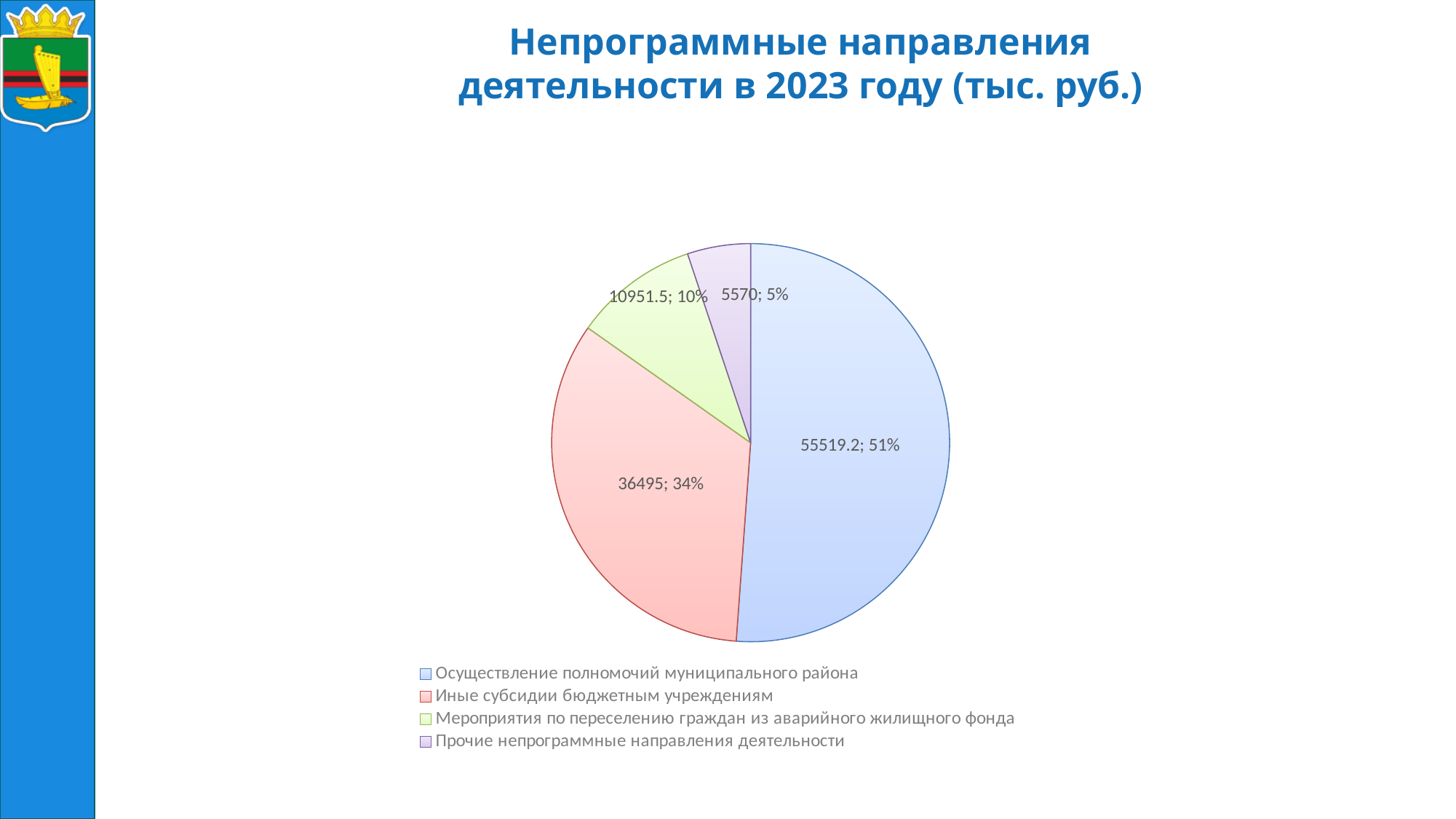
Which category has the smallest slice of the pie? Прочие непрограммные направления деятельности Which category has the largest slice of the pie? Осуществление полномочий муниципального района Which is larger: the value for "Мероприятия по переселению граждан из аварийного жилищного фонда" or the value for "Прочие непрограммные направления деятельности"? Мероприятия по переселению граждан из аварийного жилищного фонда What share of the pie does "Иные субсидии бюджетным учреждениям" represent? 34% What type of chart is shown on the slide? Pie chart How many categories does the pie chart show? 4 What is the difference between the values for "Осуществление полномочий муниципального района" and "Иные субсидии бюджетным учреждениям"? 19024.2 What share of the pie does "Мероприятия по переселению граждан из аварийного жилищного фонда" represent? 10% What is the value for "Прочие непрограммные направления деятельности"? 5570 What is the value for "Осуществление полномочий муниципального района"? 55519.2 What is the value for "Иные субсидии бюджетным учреждениям"? 36495 What is the value for "Мероприятия по переселению граждан из аварийного жилищного фонда"? 10951.5